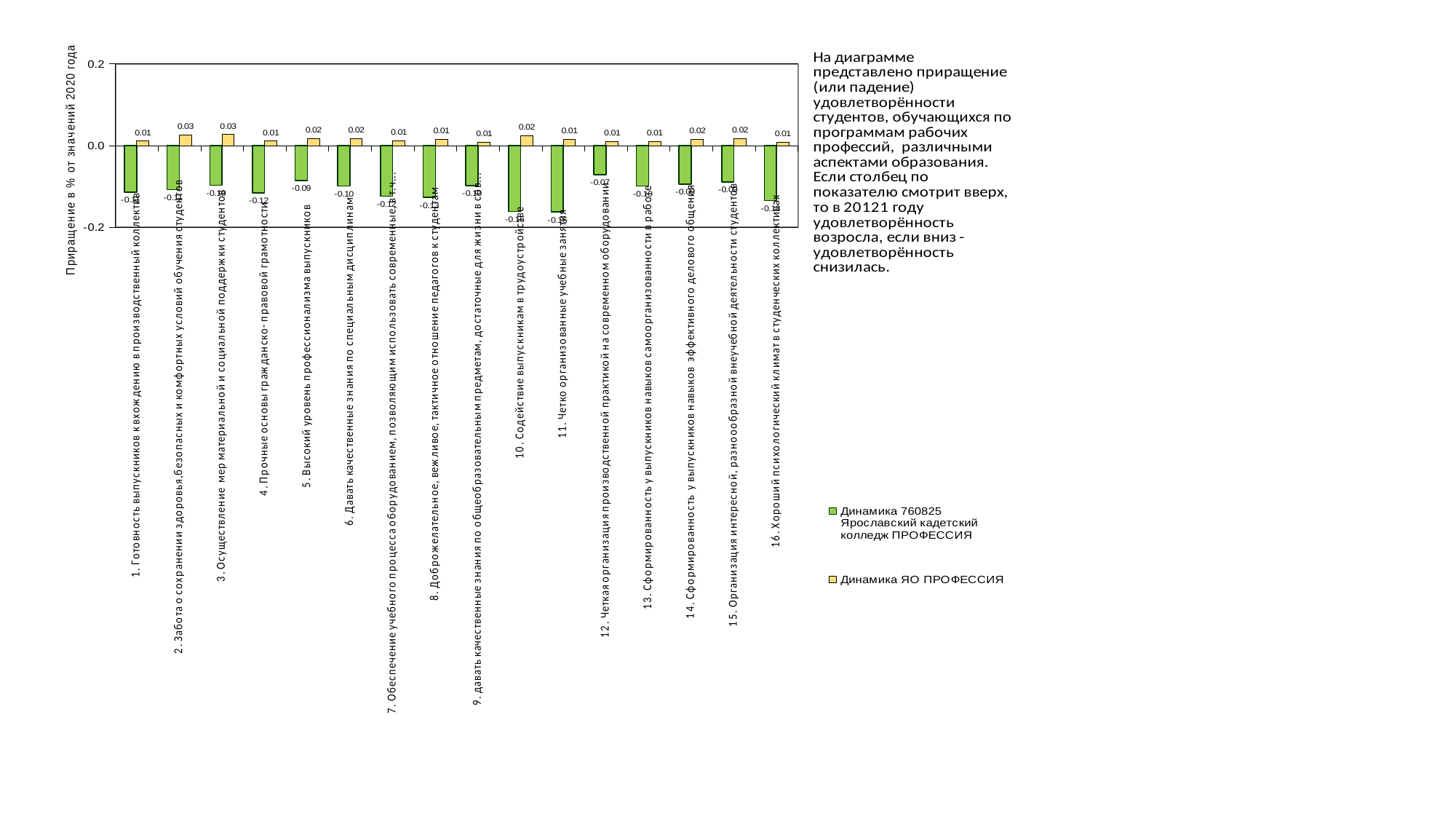
How many categories are plotted along the x axis? 16 Is the value of the 'Динамика 760825 Ярославский кадетский колледж ПРОФЕССИЯ' series for category 10 (Содействие выпускникам в трудоустройстве) greater or less than 0.0? less How many series does the legend list? 2 Which colour represents the 'Динамика ЯО ПРОФЕССИЯ' series? yellow What kind of chart is shown on the slide? bar chart What is the value of the 'Динамика ЯО ПРОФЕССИЯ' series for category 2 (Забота о сохранении здоровья, безопасных и комфортных условий обучения студентов)? 0.03 What is the value of the 'Динамика 760825 Ярославский кадетский колледж ПРОФЕССИЯ' series for category 12 (Четкая организация производственной практикой на современном оборудовании)? -0.07 What is the title of the vertical axis? Приращение в % от значений 2020 года What is the value of the 'Динамика ЯО ПРОФЕССИЯ' series for category 10 (Содействие выпускникам в трудоустройстве)? 0.02 For category 6 (Давать качественные знания по специальным дисциплинам), what is the difference between the 'Динамика ЯО ПРОФЕССИЯ' value and the 'Динамика 760825 Ярославский кадетский колледж ПРОФЕССИЯ' value? 0.12 For category 6 (Давать качественные знания по специальным дисциплинам), which series has the larger value: 'Динамика 760825 Ярославский кадетский колледж ПРОФЕССИЯ' or 'Динамика ЯО ПРОФЕССИЯ'? Динамика ЯО ПРОФЕССИЯ What is the value of the 'Динамика 760825 Ярославский кадетский колледж ПРОФЕССИЯ' series for category 5 (Высокий уровень профессионализма выпускников)? -0.09